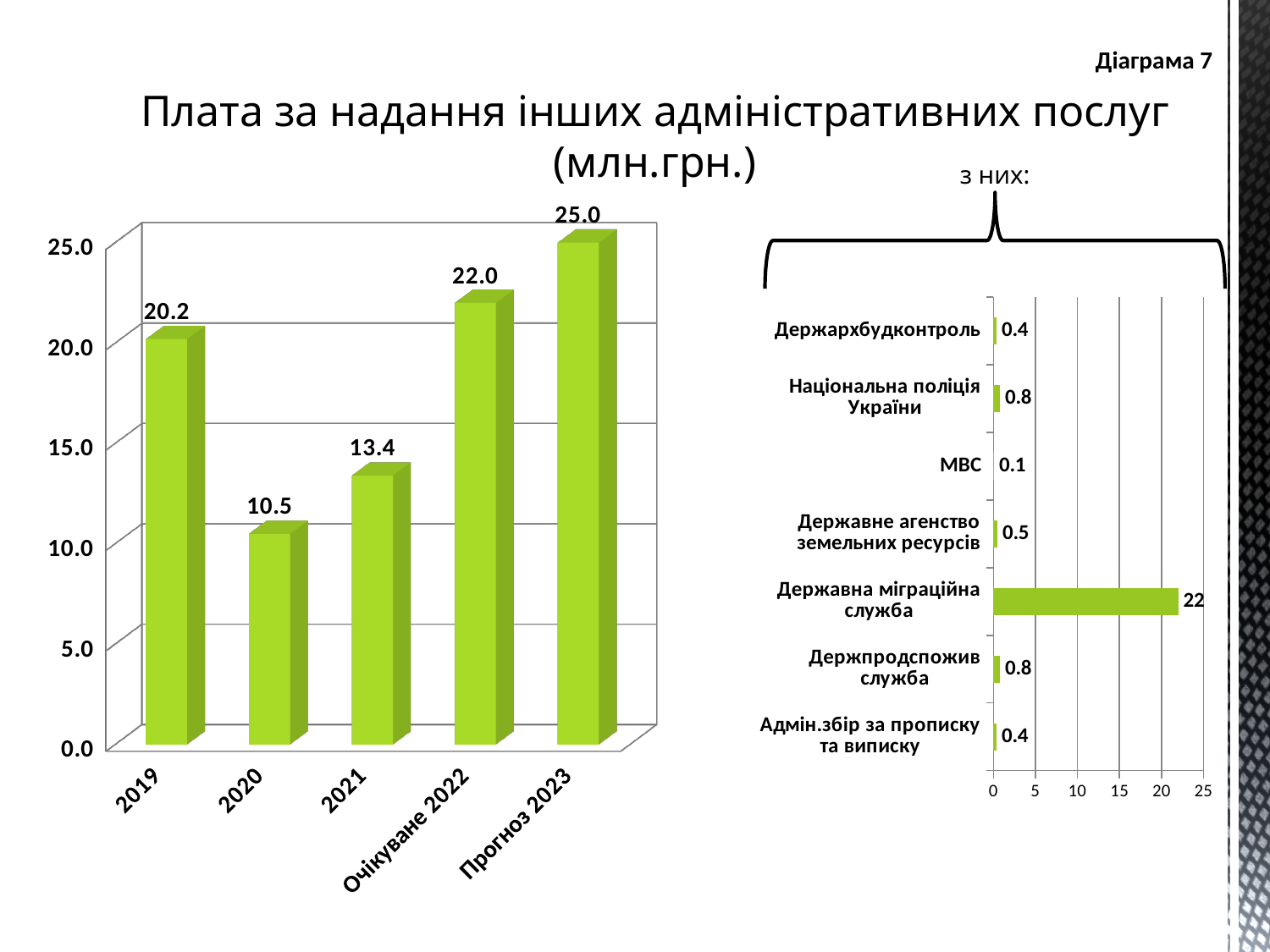
On the left chart, what is the value for 2019? 20.2 On the left chart, which is larger: the value for 2019 or the value for 2021? 2019 On the right chart, which category has the lowest value? МВС On the left chart, what is the difference between the values for Очікуване 2022 and 2021? 8.6 On the right chart, what is the difference between the values for Національна поліція України and Держархбудконтроль? 0.4 On the left chart, which category has the highest value? Прогноз 2023 What kind of chart is the left chart? bar chart On the right chart, what is the value for Державна міграційна служба? 22 How many categories are shown on the left chart? 5 On the left chart, what is the value for Прогноз 2023? 25.0 How many categories are shown on the right chart? 7 On the left chart, which category has the lowest value? 2020